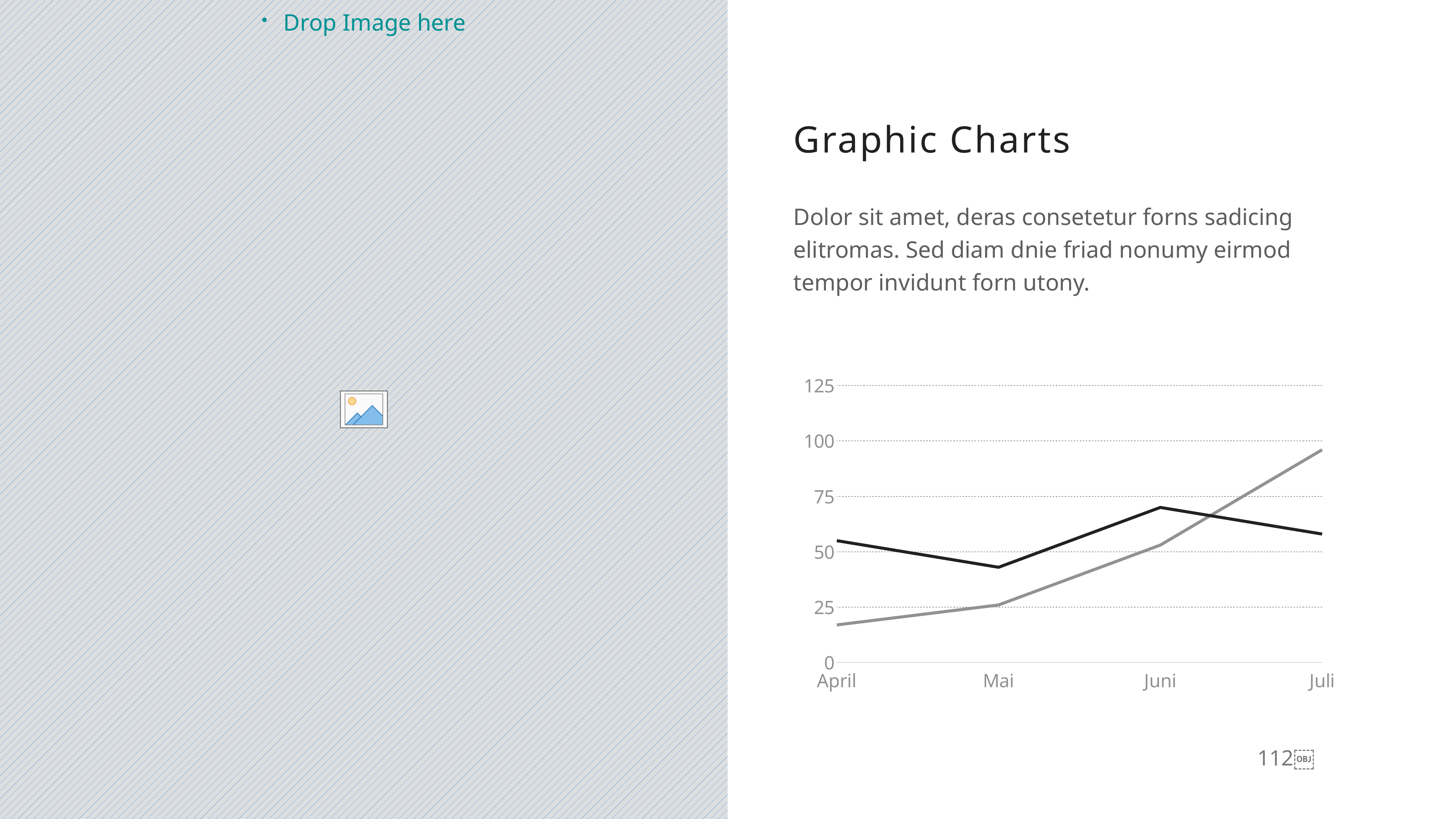
In April, which line has the higher value, the black line or the grey line? the black line What kind of chart is shown on the slide? line chart Is the value of the grey line in April greater or less than 25? less In which month does the grey line reach its highest value? Juli How many lines are plotted in the chart? 2 Is the value of the black line in Juni greater or less than 50? greater Is the value of the grey line in Juli greater or less than 75? greater How many categories are shown on the x axis of the chart? 4 In which month does the grey line have its lowest value? April Does the grey line rise or fall from April to Juli? rise In which month does the black line have its lowest value? Mai In which month does the black line reach its highest value? Juni